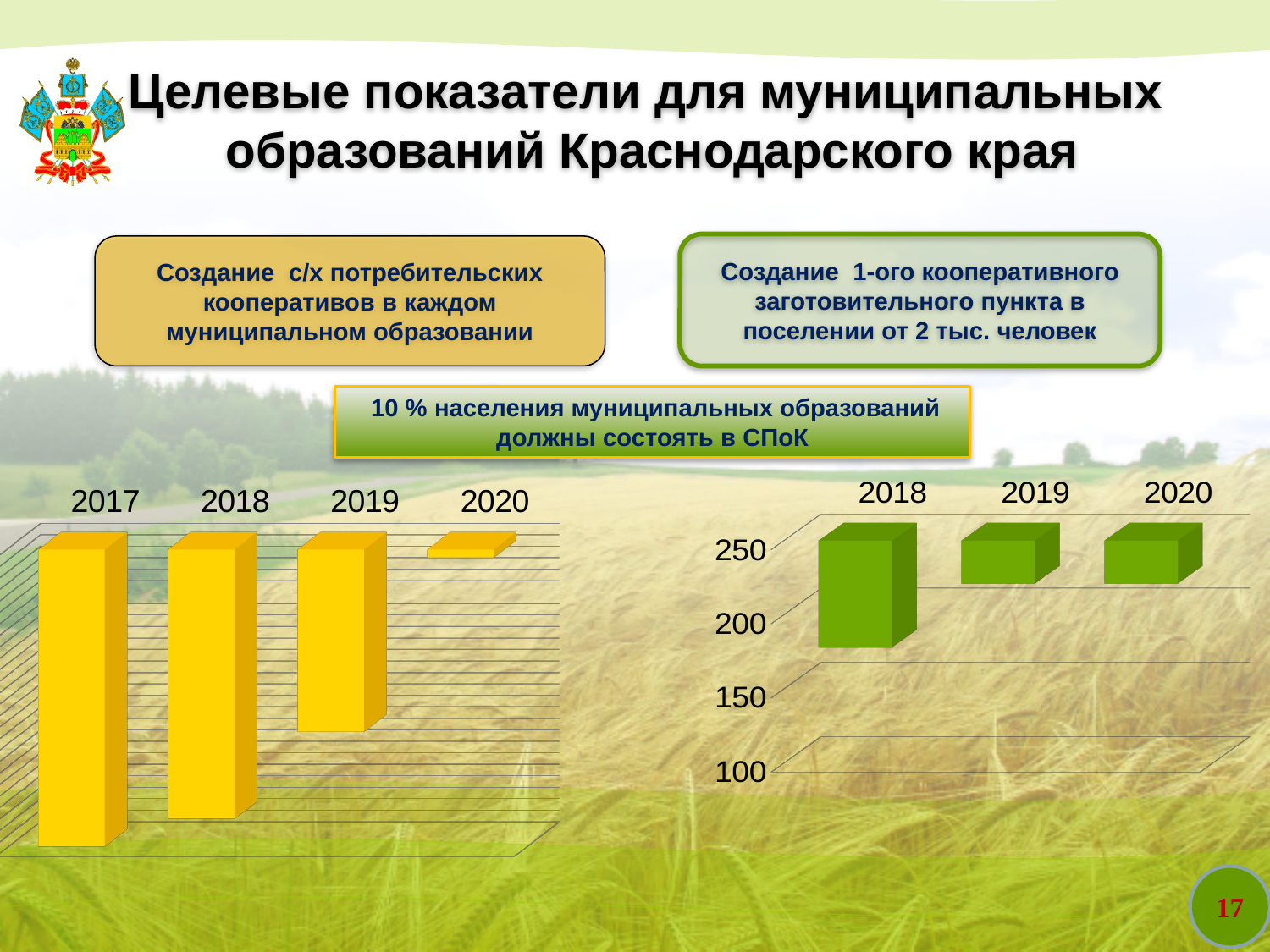
In the left chart with the yellow bars, which year has the tallest bar? 2017 Which years are labelled on the x axis of the right chart with the green bars? 2018, 2019, 2020 How many categories (years) does the left chart with the yellow bars show? 4 In the left chart with the yellow bars, which year has the shortest bar? 2020 What kind of chart is the left chart with the yellow bars? bar chart What is the highest value labelled on the axis of the right chart with the green bars? 250 In the left chart with the yellow bars, which bar is taller, 2019 or 2020? 2019 What kind of chart is the right chart with the green bars? bar chart In the left chart with the yellow bars, which bar is taller, 2018 or 2019? 2018 How many categories (years) does the right chart with the green bars show? 3